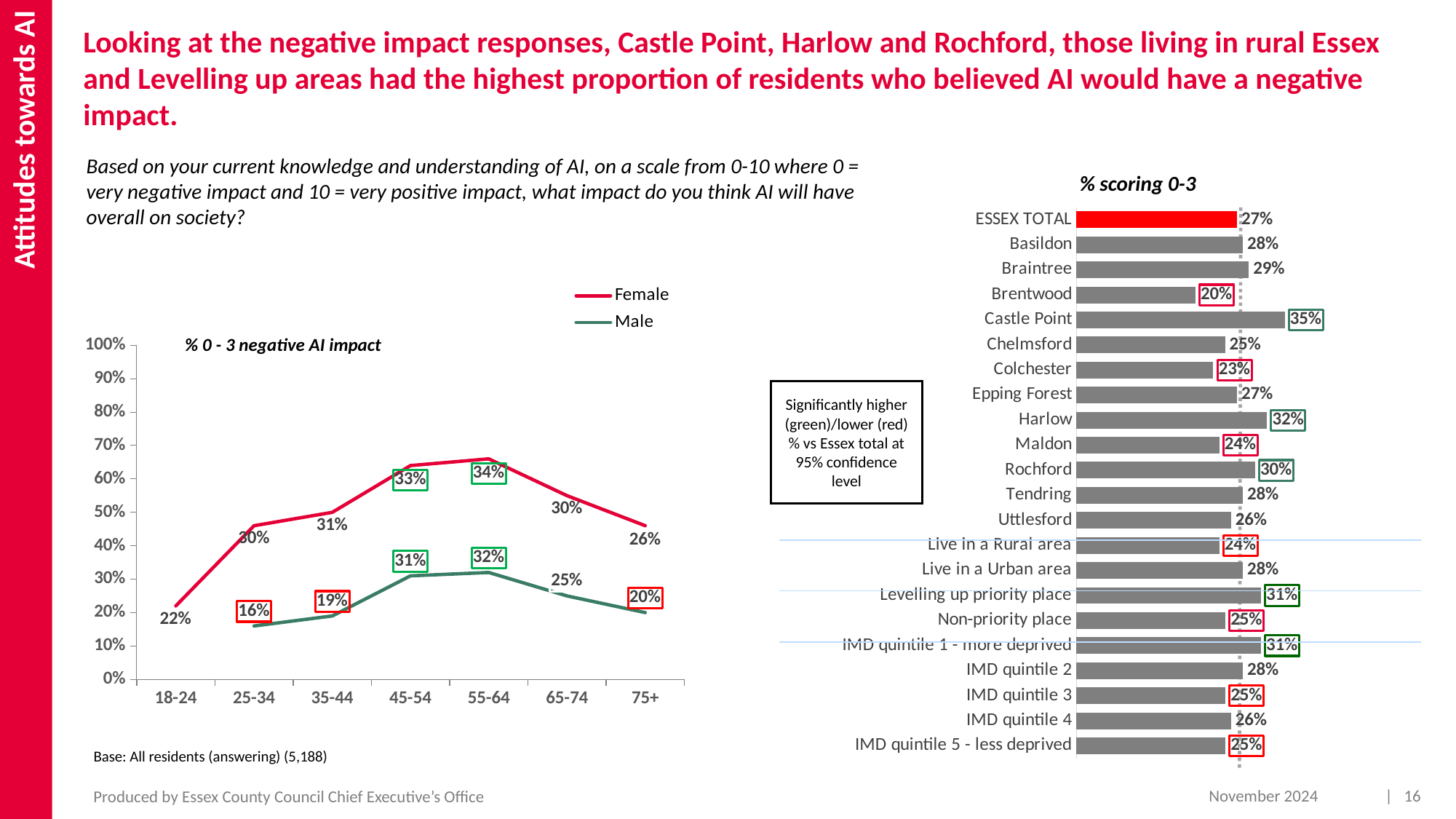
How many series does the legend of the '% 0 - 3 negative AI impact' chart on the left list? 2 In the '% scoring 0-3' bar chart on the right, what is the value for Castle Point? 35% In the '% 0 - 3 negative AI impact' chart on the left, what is the Male value for the 25-34 age group? 16% In the '% scoring 0-3' bar chart on the right, which category has the highest value? Castle Point In the '% scoring 0-3' bar chart on the right, what is the difference between the Castle Point value and the ESSEX TOTAL value? 8 percentage points What kind of chart is the '% 0 - 3 negative AI impact' chart on the left? Line chart In the '% scoring 0-3' bar chart on the right, which category has the lowest value? Brentwood In the '% scoring 0-3' bar chart on the right, what is the value for Colchester? 23% In the '% 0 - 3 negative AI impact' chart on the left, what is the Female value for the 55-64 age group? 34% In the '% scoring 0-3' bar chart on the right, which is larger, the value for Harlow or the value for Rochford? Harlow In the '% 0 - 3 negative AI impact' chart on the left, what is the difference between the Female and Male values for the 35-44 age group? 12 percentage points In the '% scoring 0-3' bar chart on the right, how many categories (bars) are shown? 22